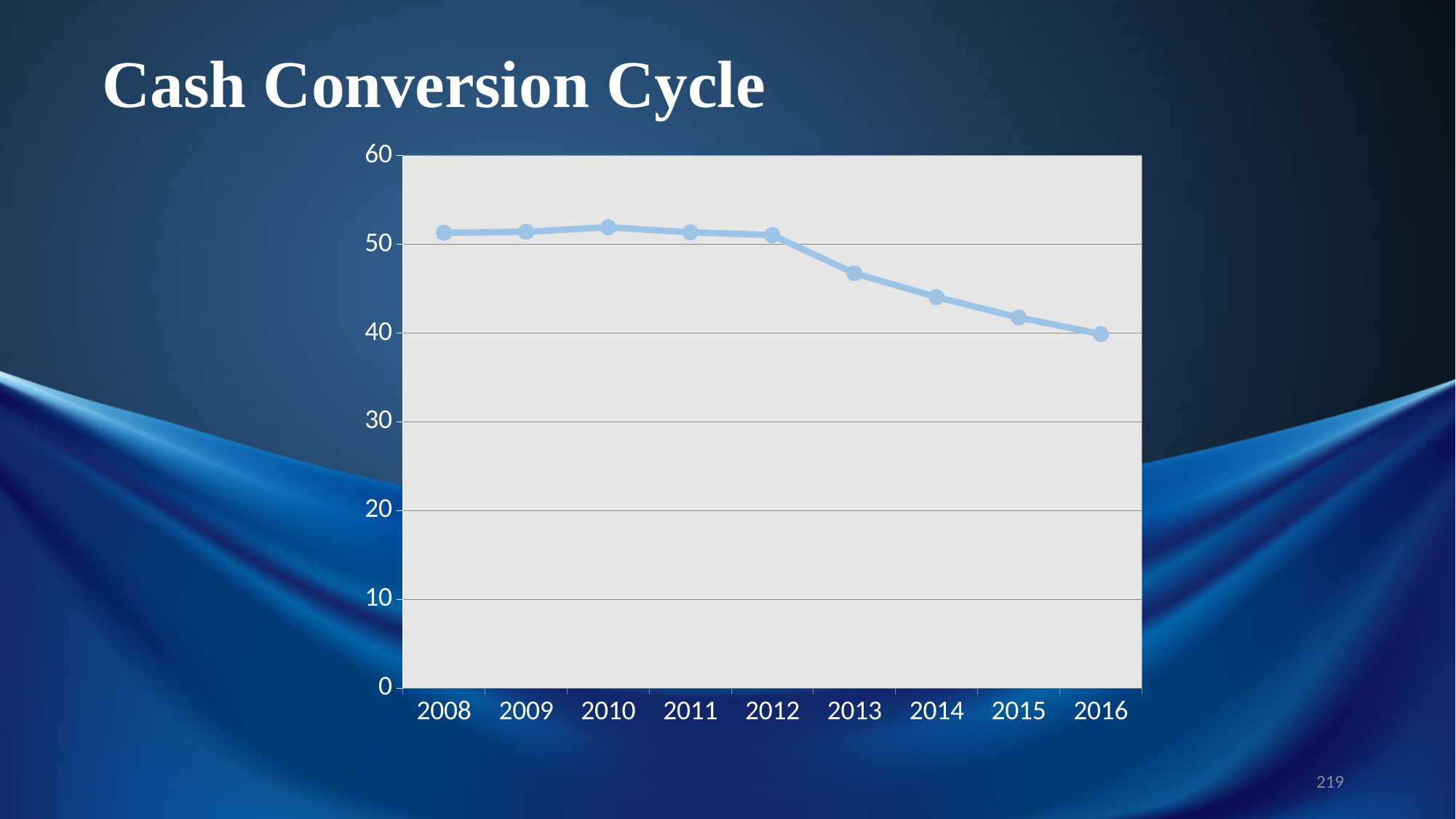
What kind of chart is shown on the slide? line chart Is the value for 2010 greater or less than 50? greater Is the value for 2014 greater or less than 40? greater Which is larger, the value for 2012 or the value for 2013? 2012 Which is larger, the value for 2014 or the value for 2016? 2014 What is the title of the chart? Cash Conversion Cycle How many years are plotted on the x axis? 9 Which year has the lowest value? 2016 What is the first year shown on the x axis? 2008 Is the value for 2015 greater or less than 50? less Do the values generally rise or fall from 2012 to 2016? fall